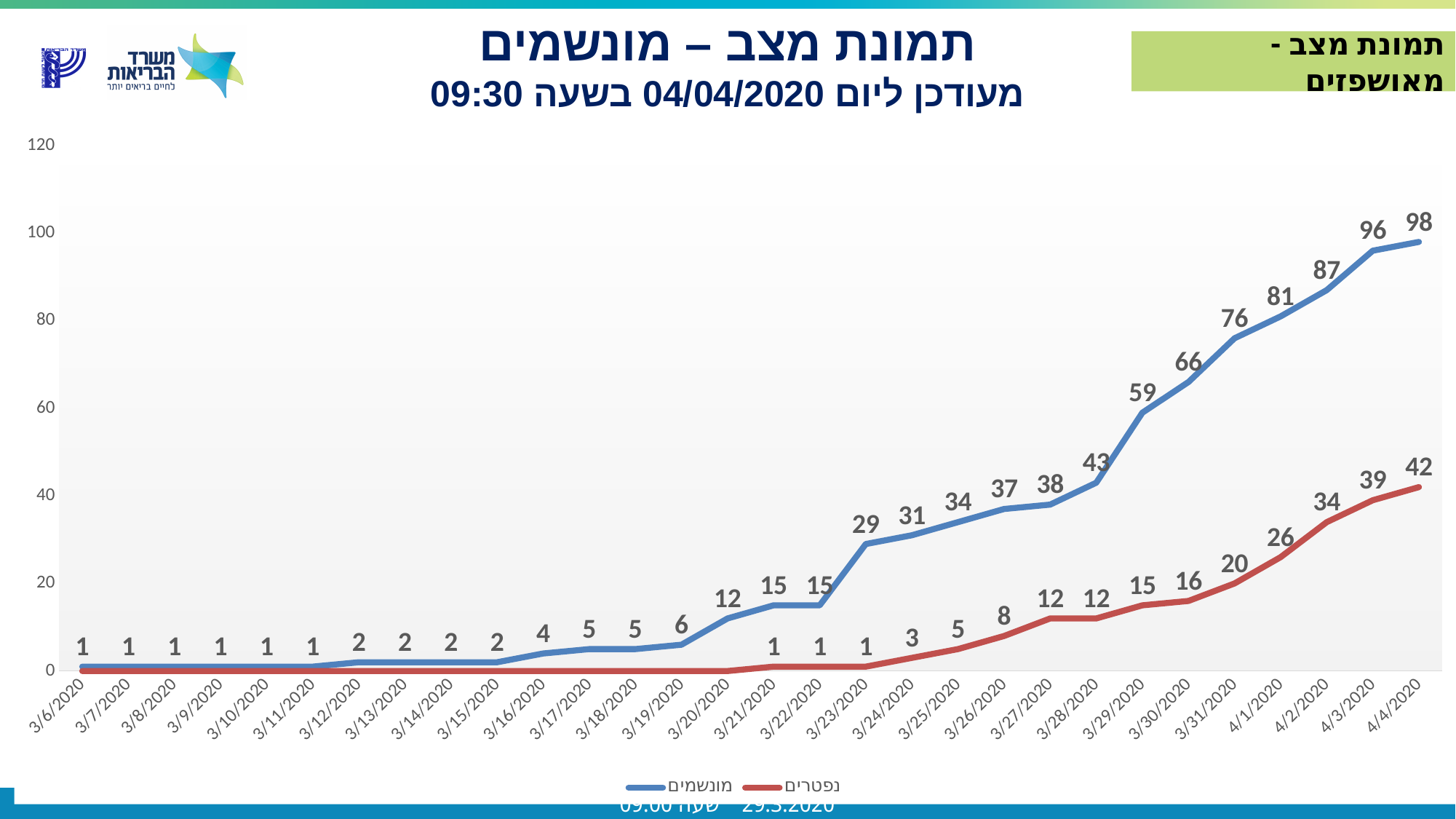
How many dates are shown on the x axis? 30 What is the difference between the מונשמים and נפטרים values on 4/4/2020? 56 What is the value of the מונשמים series on 3/23/2020? 29 What is the value of the נפטרים series on 3/31/2020? 20 How many series does the legend list? 2 Which series has the larger value on 3/29/2020, מונשמים or נפטרים? מונשמים What is the value of the נפטרים series on 4/4/2020? 42 Does the מונשמים series rise or fall from 3/6/2020 to 4/4/2020? rise What type of chart is shown on the slide? line chart What is the value of the מונשמים series on 4/4/2020? 98 On which date does the מונשמים series reach its highest value? 4/4/2020 What is the difference between the מונשמים values on 4/3/2020 and 4/2/2020? 9